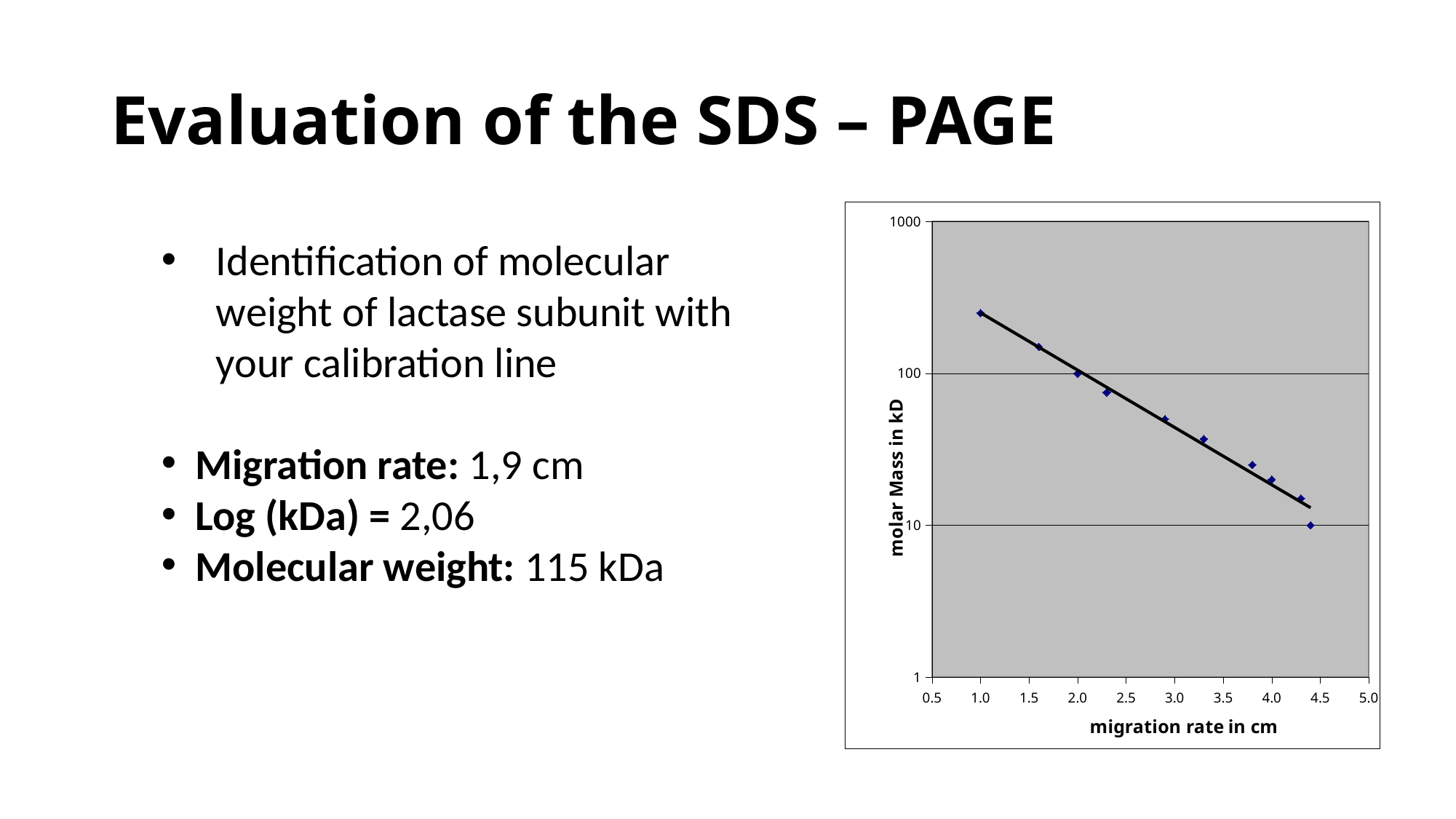
What kind of chart is shown on the slide? scatter chart Which point has the larger molar mass: the one at a migration rate of 1.0 cm or the one at 4.0 cm? 1.0 cm Is the molar mass of the point at a migration rate of 4.0 cm greater or less than 100? less How many data points are plotted on the chart? 10 At which migration rate does the point with the highest molar mass lie? 1.0 cm What is the highest value shown on the y axis of the chart? 1000 Is the molar mass of the point at a migration rate of 1.0 cm greater or less than 100? greater Is the molar mass of the point at a migration rate of 4.0 cm greater or less than 10? greater Does the molar mass rise or fall as the migration rate increases along the x axis? fall What is the label of the y axis of the chart? molar Mass in kD What is the label of the x axis of the chart? migration rate in cm